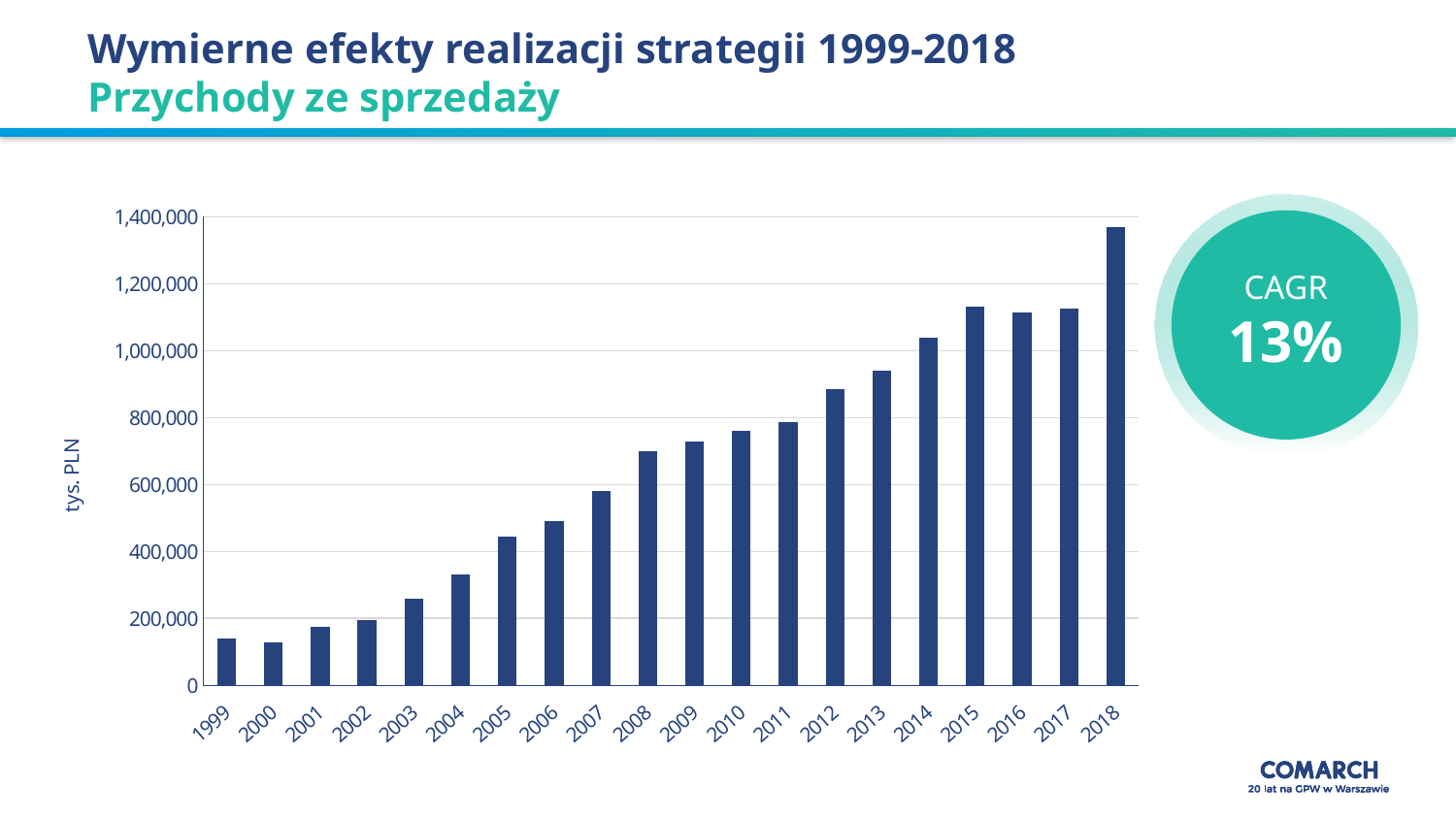
Is the value for 2018 greater or less than 1,200,000? greater Is the value for 2014 greater or less than 1,000,000? greater What unit is given on the y axis of the chart? tys. PLN Which is larger, the value for 2010 or the value for 2013? 2013 How many years are shown on the x axis of the chart? 20 Is the value for 2004 greater or less than 400,000? less Do the values generally rise or fall from 1999 to 2018? rise Which year has the highest sales revenue in the chart? 2018 What kind of chart is shown on the slide? bar chart Which is larger, the value for 2003 or the value for 2005? 2005